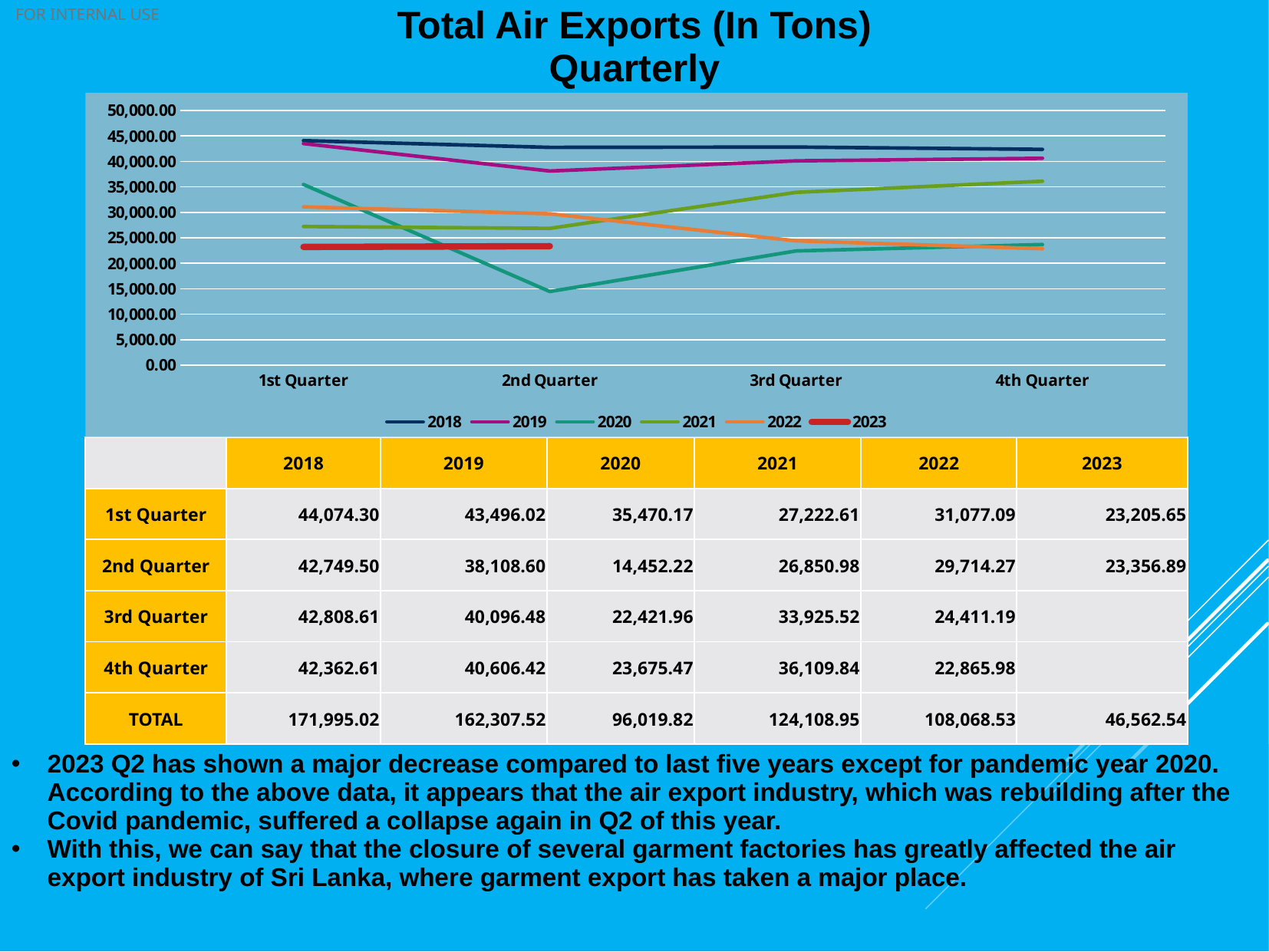
Which year has the lowest value in the 2nd Quarter? 2020 What is the title of the chart? Total Air Exports (In Tons) Quarterly How many series does the legend list? 6 What is the value for 2023 in the 1st Quarter? 23,205.65 Which is larger in the 4th Quarter, the value for 2021 or the value for 2022? 2021 What is the value for 2020 in the 2nd Quarter? 14,452.22 How many quarters are plotted along the x axis? 4 Is the value for 2020 in the 2nd Quarter greater or less than 15,000.00? less What kind of chart is shown on the slide? line chart Which year has the highest value in the 1st Quarter? 2018 Do the values for 2022 rise or fall from the 1st Quarter to the 4th Quarter? fall What is the difference between the 2018 and 2019 values in the 1st Quarter? 578.28